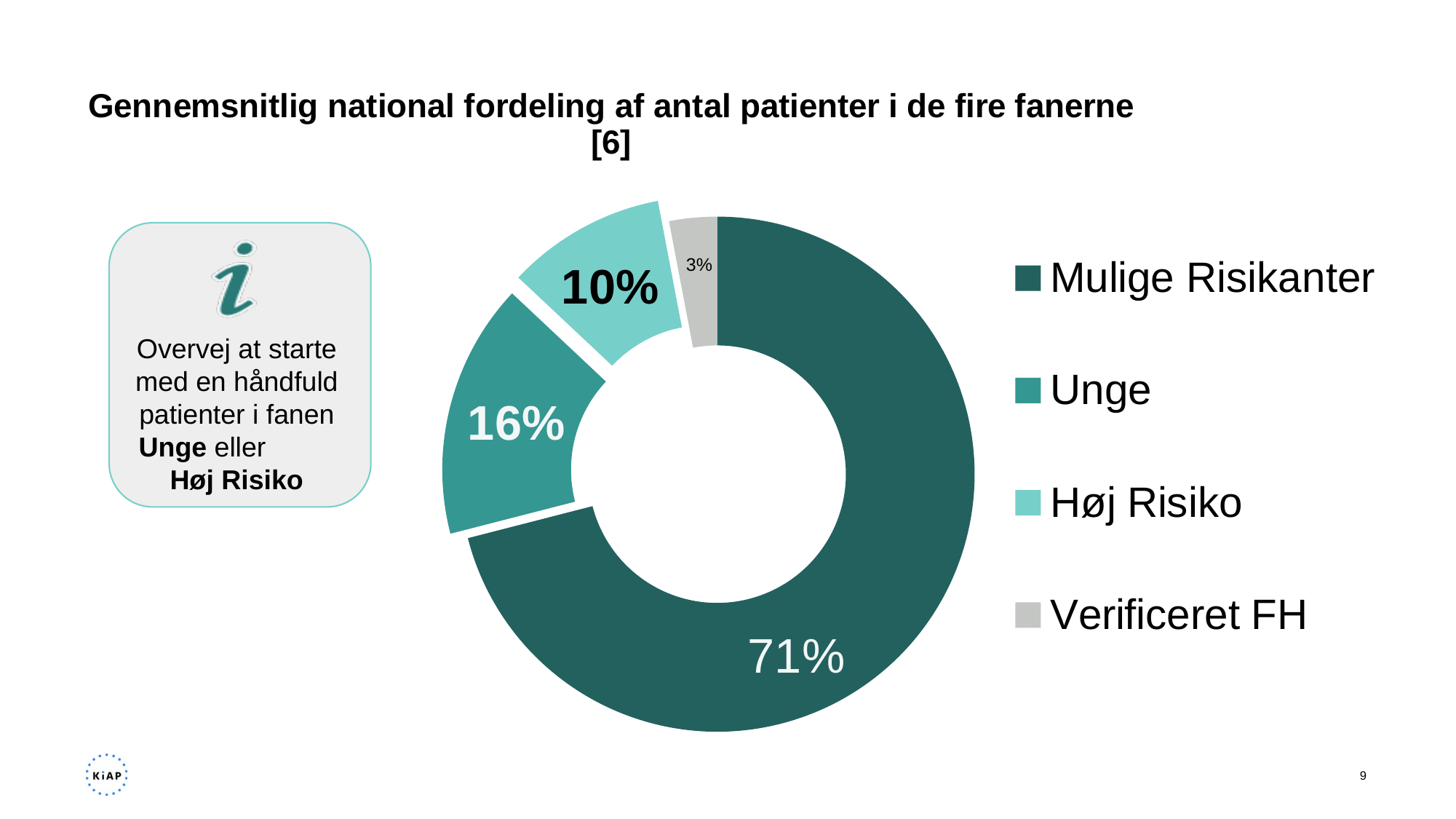
Which category has the largest share of patients? Mulige Risikanter What share of patients is in the Verificeret FH category? 3% Which category has the smallest share of patients? Verificeret FH What kind of chart is shown on the slide? Pie chart (doughnut) Which is larger, the share for Unge or the share for Høj Risiko? Unge How many categories does the chart show? 4 What is the difference in percentage points between Mulige Risikanter and Unge? 55 What share of patients is in the Unge category? 16% What is the title of the chart? Gennemsnitlig national fordeling af antal patienter i de fire fanerne [6] What share of patients is in the Mulige Risikanter category? 71% What is the difference in percentage points between Unge and Høj Risiko? 6 What share of patients is in the Høj Risiko category? 10%